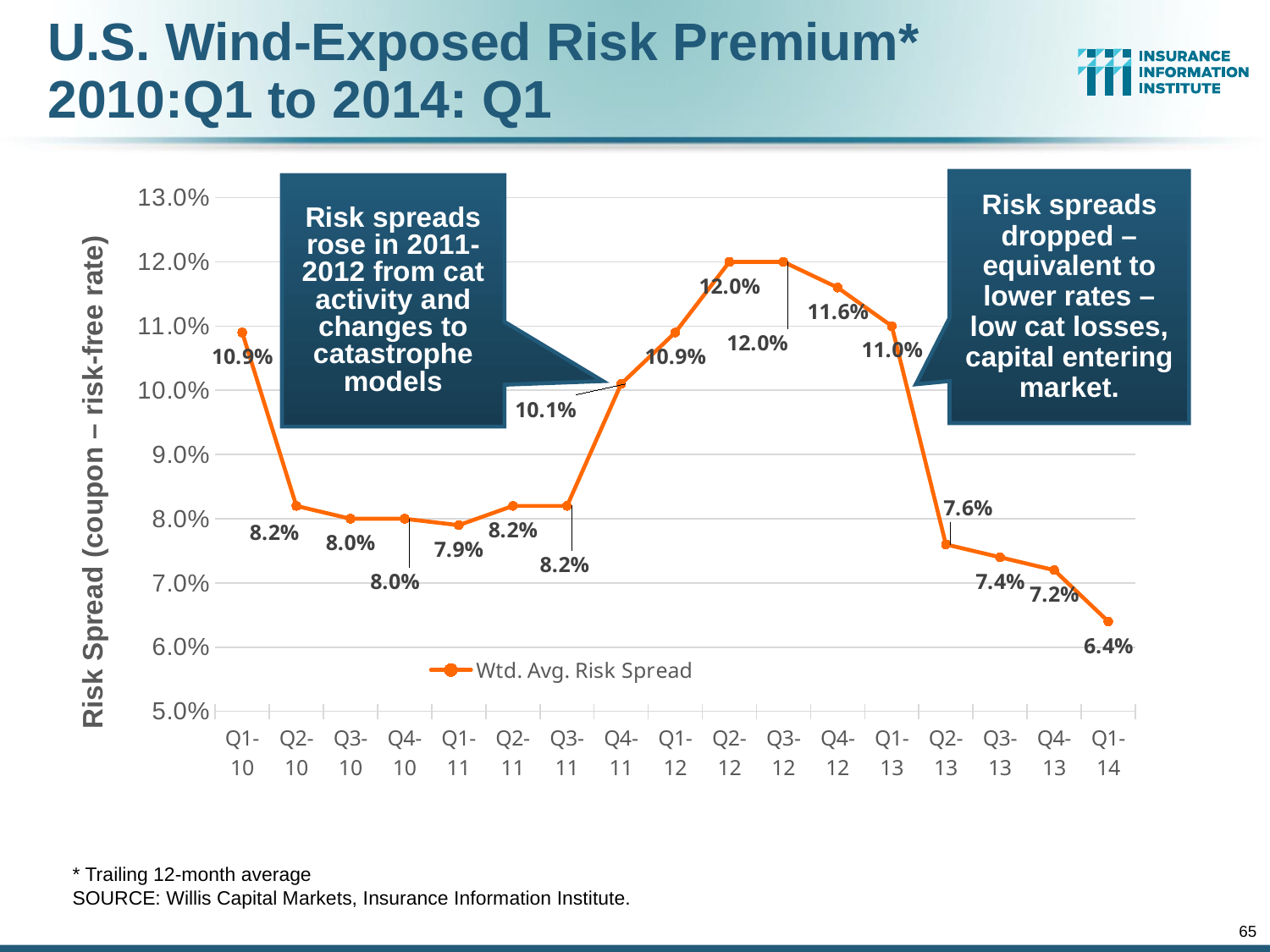
How many quarters are plotted on the x axis? 17 What is the weighted average risk spread for Q1-10? 10.9% What is the difference between the risk spread in Q1-10 and Q1-14? 4.5 percentage points Is the value for Q3-12 greater or less than 11.0%? greater Which is larger, the risk spread for Q4-12 or for Q1-13? Q4-12 How many series does the legend list? 1 Which quarter has the lowest risk spread? Q1-14 What value is shown for Q4-11? 10.1% What is the weighted average risk spread for Q1-14? 6.4% What value is shown for Q2-13? 7.6% What is the highest risk spread value shown on the chart? 12.0% What kind of chart is shown on the slide? Line chart